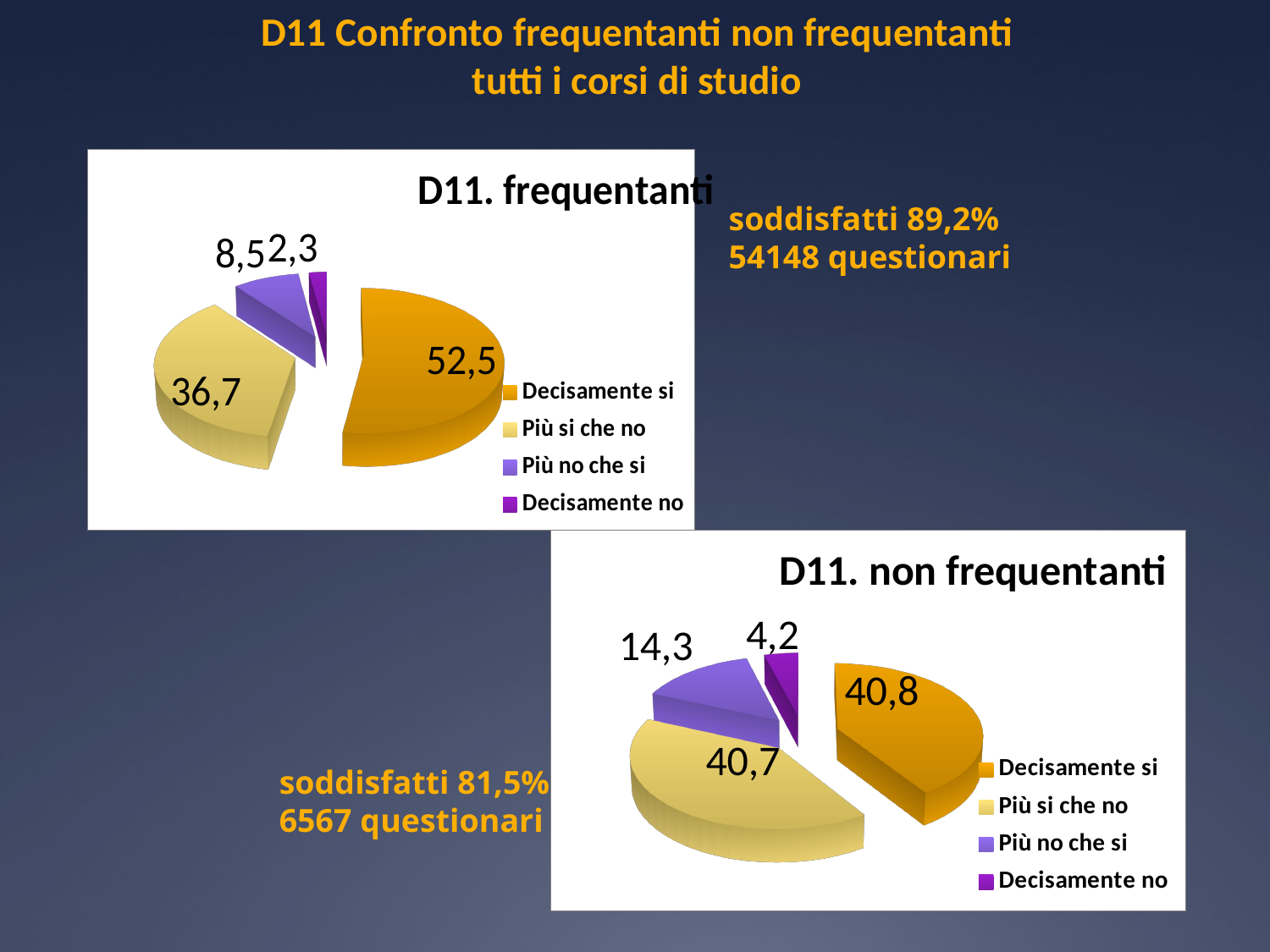
In the "D11. frequentanti" pie chart, what is the value for "Più si che no"? 36,7 How many categories does the legend of the "D11. frequentanti" pie chart list? 4 In the "D11. frequentanti" pie chart, which category has the largest slice? Decisamente si In the "D11. frequentanti" pie chart, what is the value for "Decisamente si"? 52,5 In the "D11. non frequentanti" pie chart, what is the difference between the values for "Più no che si" and "Decisamente no"? 10,1 In the "D11. frequentanti" pie chart, which category has the smallest slice? Decisamente no In the "D11. non frequentanti" pie chart, what is the value for "Decisamente no"? 4,2 What type of chart is "D11. non frequentanti"? pie chart In the "D11. frequentanti" pie chart, what is the difference between the values for "Decisamente si" and "Più si che no"? 15,8 In the "D11. non frequentanti" pie chart, which category has the smallest slice? Decisamente no In the "D11. non frequentanti" pie chart, is the value for "Più no che si" larger or smaller than the value for "Decisamente no"? larger In the "D11. non frequentanti" pie chart, what is the value for "Più no che si"? 14,3